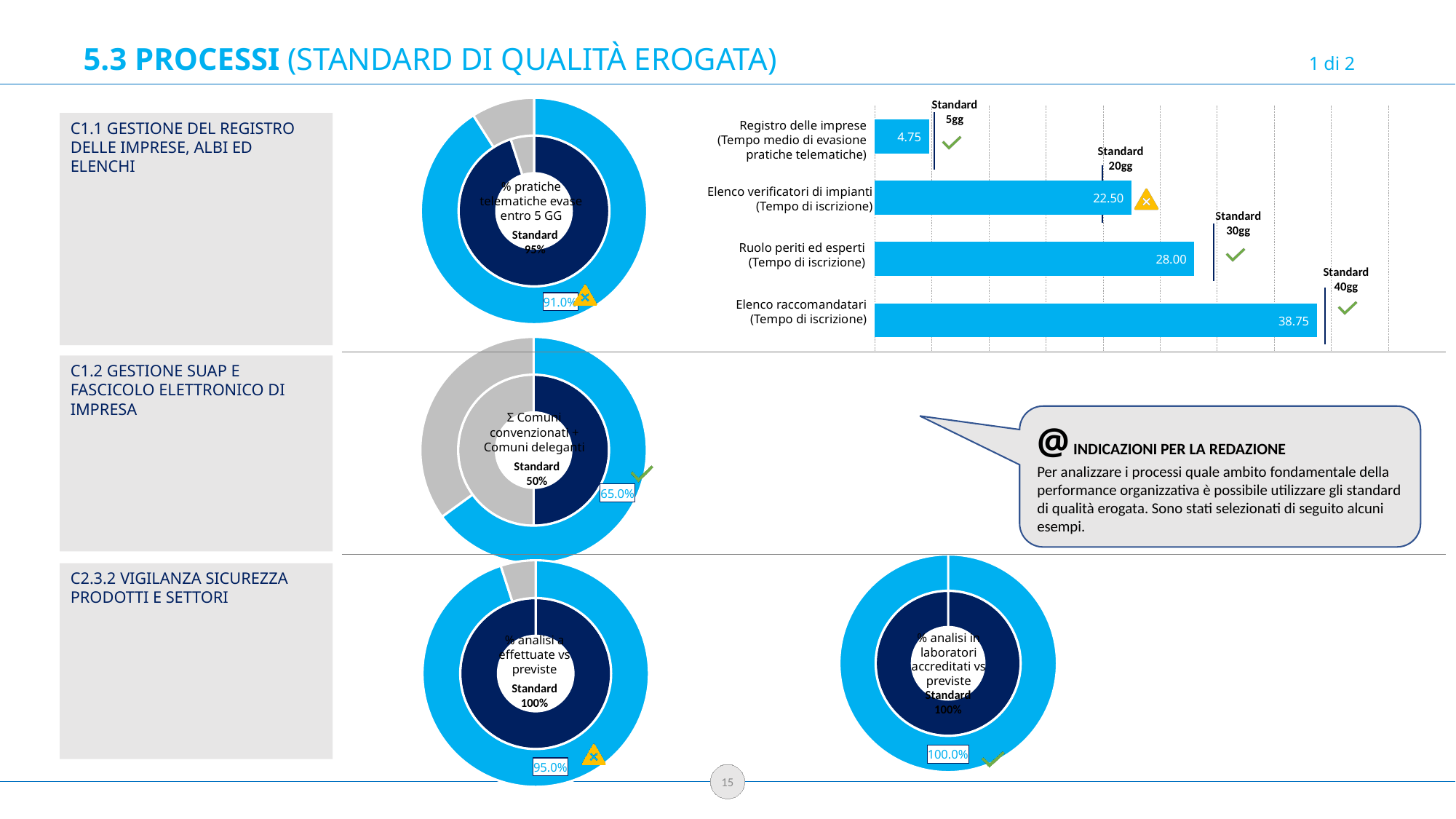
What kind of chart is the one at the top right showing Registro delle imprese, Elenco verificatori di impianti, Ruolo periti ed esperti and Elenco raccomandatari? bar chart In the horizontal bar chart at the top right, what is the value for Elenco raccomandatari (Tempo di iscrizione)? 38.75 In the donut chart for C1.1 (% pratiche telematiche evase entro 5 GG), what value is shown as the data label? 91.0% In the donut chart for C2.3.2 on the right (% analisi in laboratori accreditati vs previste), what value is shown as the data label? 100.0% In the horizontal bar chart at the top right, what is the value for Elenco verificatori di impianti (Tempo di iscrizione)? 22.50 In the horizontal bar chart at the top right, which category has the lowest value? Registro delle imprese (Tempo medio di evasione pratiche telematiche) In the donut chart for C1.2 (Σ Comuni convenzionati + Comuni deleganti), what value is shown as the data label? 65.0% In the horizontal bar chart at the top right, what is the difference between the values for Ruolo periti ed esperti and Elenco verificatori di impianti? 5.50 In the horizontal bar chart at the top right, what is the value for Registro delle imprese (Tempo medio di evasione pratiche telematiche)? 4.75 In the donut chart for C2.3.2 on the left (% analisi a effettuate vs previste), what value is shown as the data label? 95.0% In the horizontal bar chart at the top right, which category has the highest value? Elenco raccomandatari (Tempo di iscrizione) In the horizontal bar chart at the top right, how many categories are shown? 4